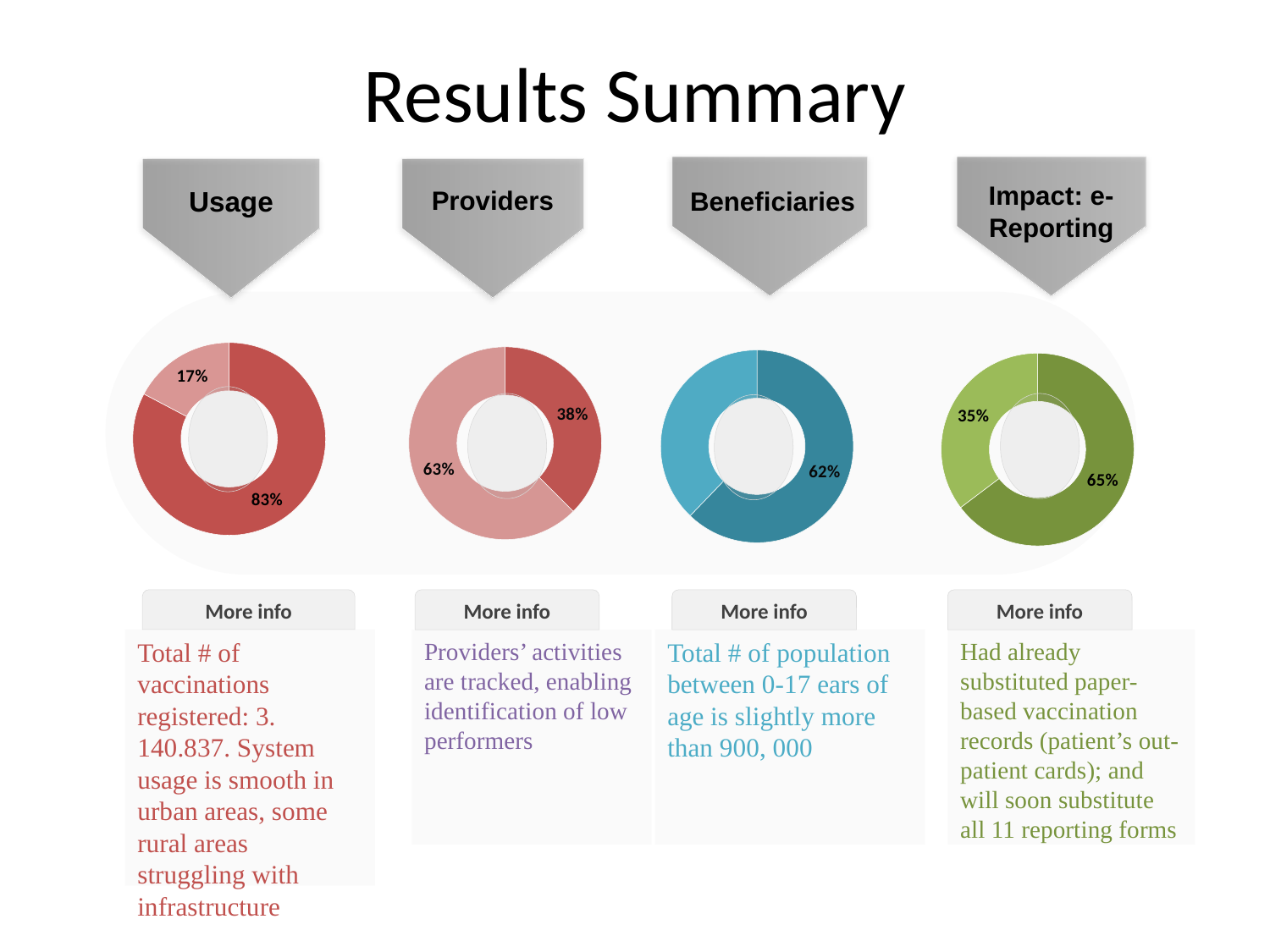
In the "Impact: e-Reporting" chart, what is the value of the largest slice? 65% In the "Providers" chart, what is the value of the smallest slice? 38% Which chart has the larger largest slice: the "Usage" chart or the "Impact: e-Reporting" chart? Usage In the "Providers" chart, what is the difference between the two labelled slices? 25 percentage points In the "Usage" chart, what is the value of the smallest slice? 17% In the "Usage" chart, what is the value of the largest slice? 83% In the "Beneficiaries" chart, what value is printed on the labelled slice? 62% In the "Usage" chart, what is the difference between the two labelled slices? 66 percentage points What kind of chart is shown under the "Usage" heading? donut chart In the "Impact: e-Reporting" chart, what is the difference between the two labelled slices? 30 percentage points In the "Providers" chart, what is the value of the largest slice? 63% How many donut charts are shown on the slide? 4